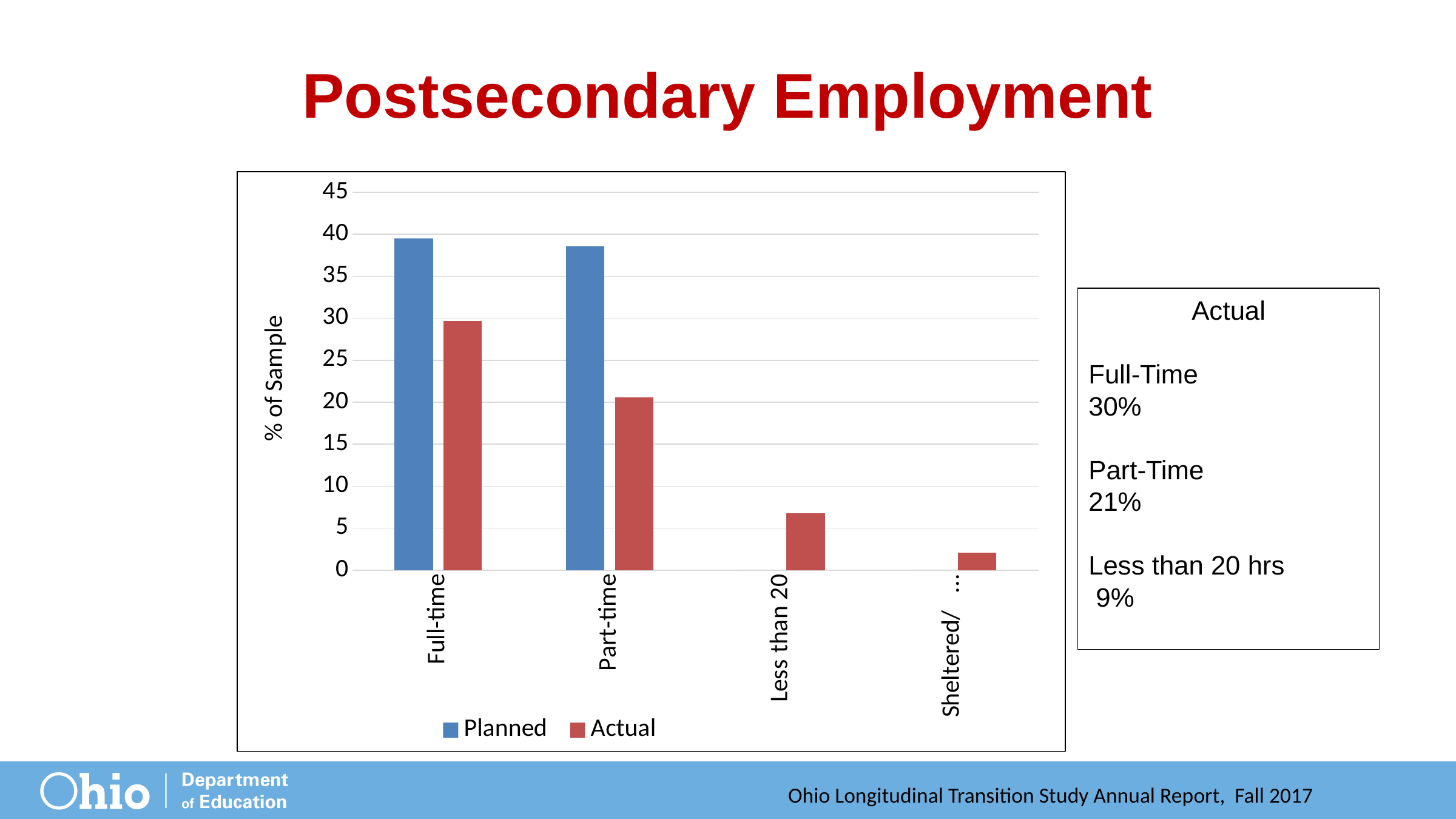
What is the label on the y axis of the chart? % of Sample How many categories are shown on the x axis of the chart? 4 Which category has the highest Actual value? Full-time Is the Planned value for Full-time greater or less than 35? greater Is the Actual value for Less than 20 greater or less than 10? less For Part-time, which is larger, the Planned or the Actual value? Planned Is the Actual value for Full-time greater or less than 25? greater For Full-time, which is larger, the Planned or the Actual value? Planned What kind of chart is shown on the slide? bar chart How many series does the chart legend list? 2 Do the Actual values rise or fall moving from left to right along the x axis? fall